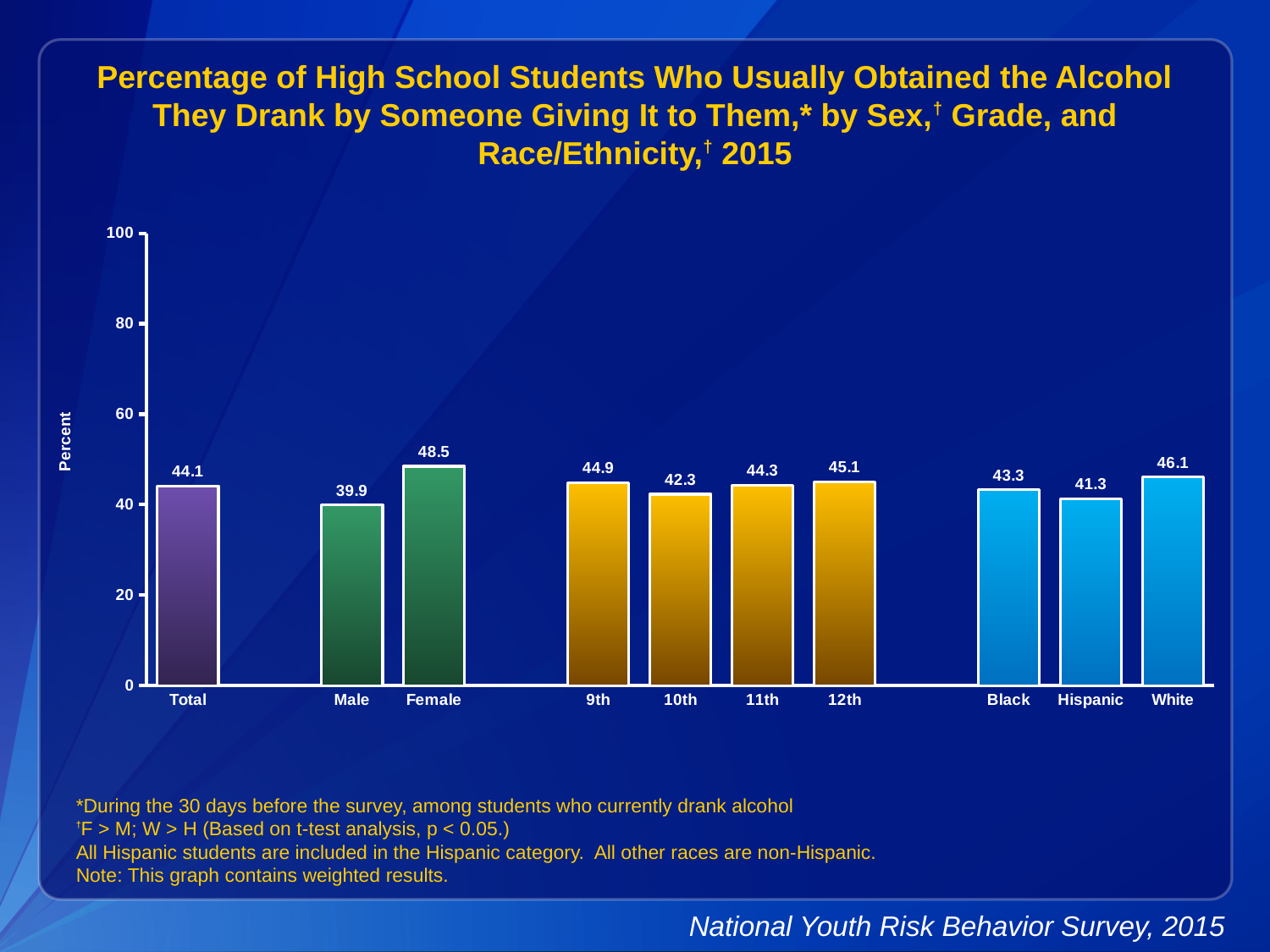
What kind of chart is shown on the slide? bar chart How many bars are shown in the chart? 10 What is the value for 10th grade? 42.3 Which category has the highest value? Female Is the value for Black greater or less than 60? less What is the value for Hispanic? 41.3 Which is larger, the value for 12th grade or the value for 9th grade? 12th What is the difference between the Female and Male values? 8.6 Which category has the lowest value? Male What is the difference between the White and Hispanic values? 4.8 What is the value for Total? 44.1 What is the value for Female? 48.5